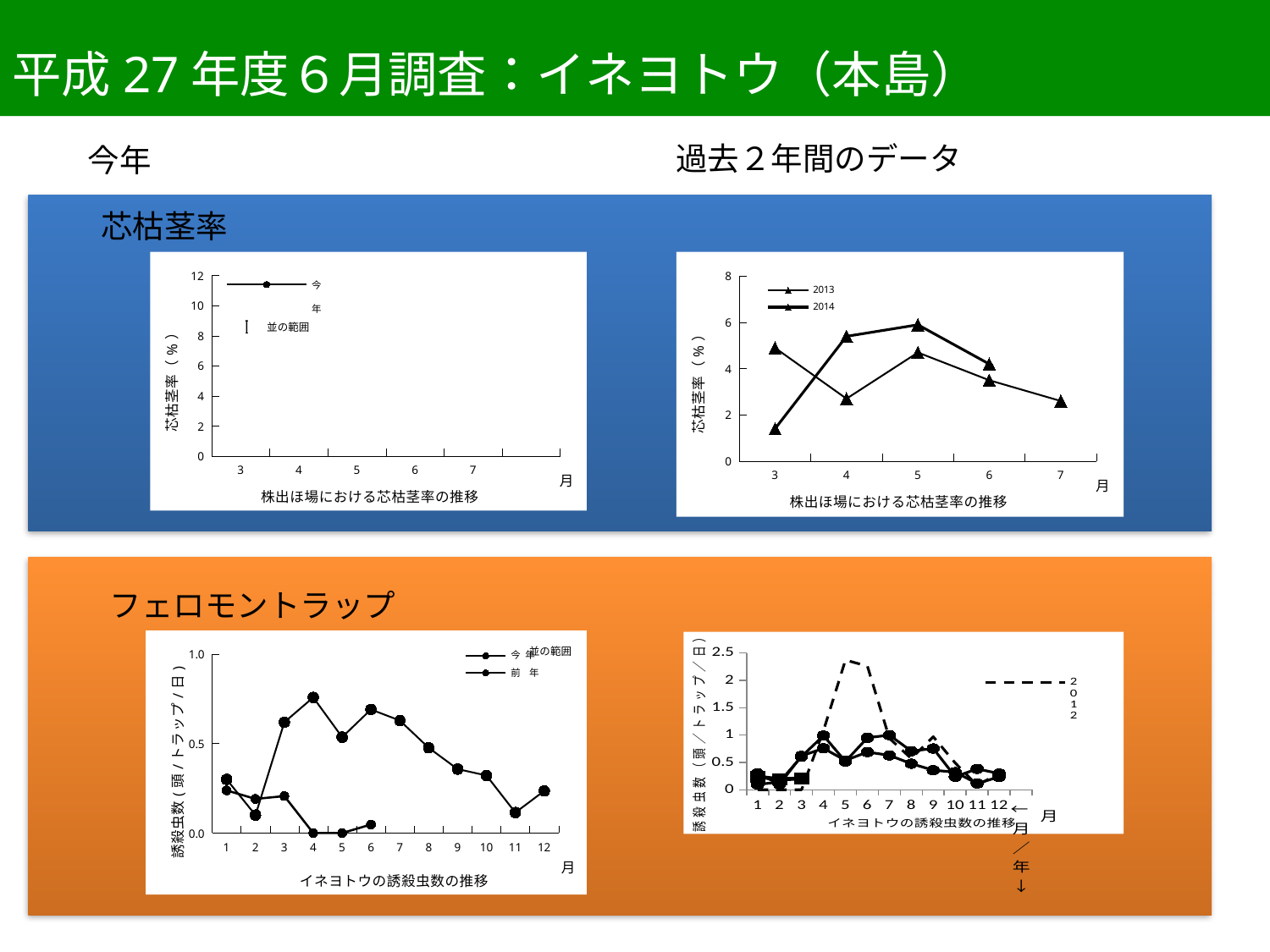
On the bottom-right chart (イネヨトウの誘殺虫数の推移, 過去2年間のデータ), in which month does the dashed 2012 line reach its peak? 5 On the top-right chart (株出ほ場における芯枯茎率の推移, 過去2年間のデータ), what kind of chart is it? line chart On the top-right chart (株出ほ場における芯枯茎率の推移, 過去2年間のデータ), does the 2013 series rise or fall from month 5 to month 7? fall On the top-left chart (株出ほ場における芯枯茎率の推移, 今年), what is the highest tick value shown on the y axis? 12 On the top-right chart (株出ほ場における芯枯茎率の推移, 過去2年間のデータ), is the 2014 value at month 3 greater or less than 2? less On the top-right chart (株出ほ場における芯枯茎率の推移, 過去2年間のデータ), how many series does the legend list? 2 On the top-right chart (株出ほ場における芯枯茎率の推移, 過去2年間のデータ), in which month does the 2014 series reach its highest value? 5 On the bottom-left chart (イネヨトウの誘殺虫数の推移, 今年), in which month does the highest plotted point occur? 4 On the bottom-left chart (イネヨトウの誘殺虫数の推移, 今年), how many months are shown on the x axis? 12 On the bottom-left chart (イネヨトウの誘殺虫数の推移, 今年), is the highest plotted value at month 4 greater or less than 0.5? greater On the top-right chart (株出ほ場における芯枯茎率の推移, 過去2年間のデータ), at month 4, which series has the larger value, 2013 or 2014? 2014 On the top-right chart (株出ほ場における芯枯茎率の推移, 過去2年間のデータ), is the 2013 value at month 3 greater or less than 4? greater